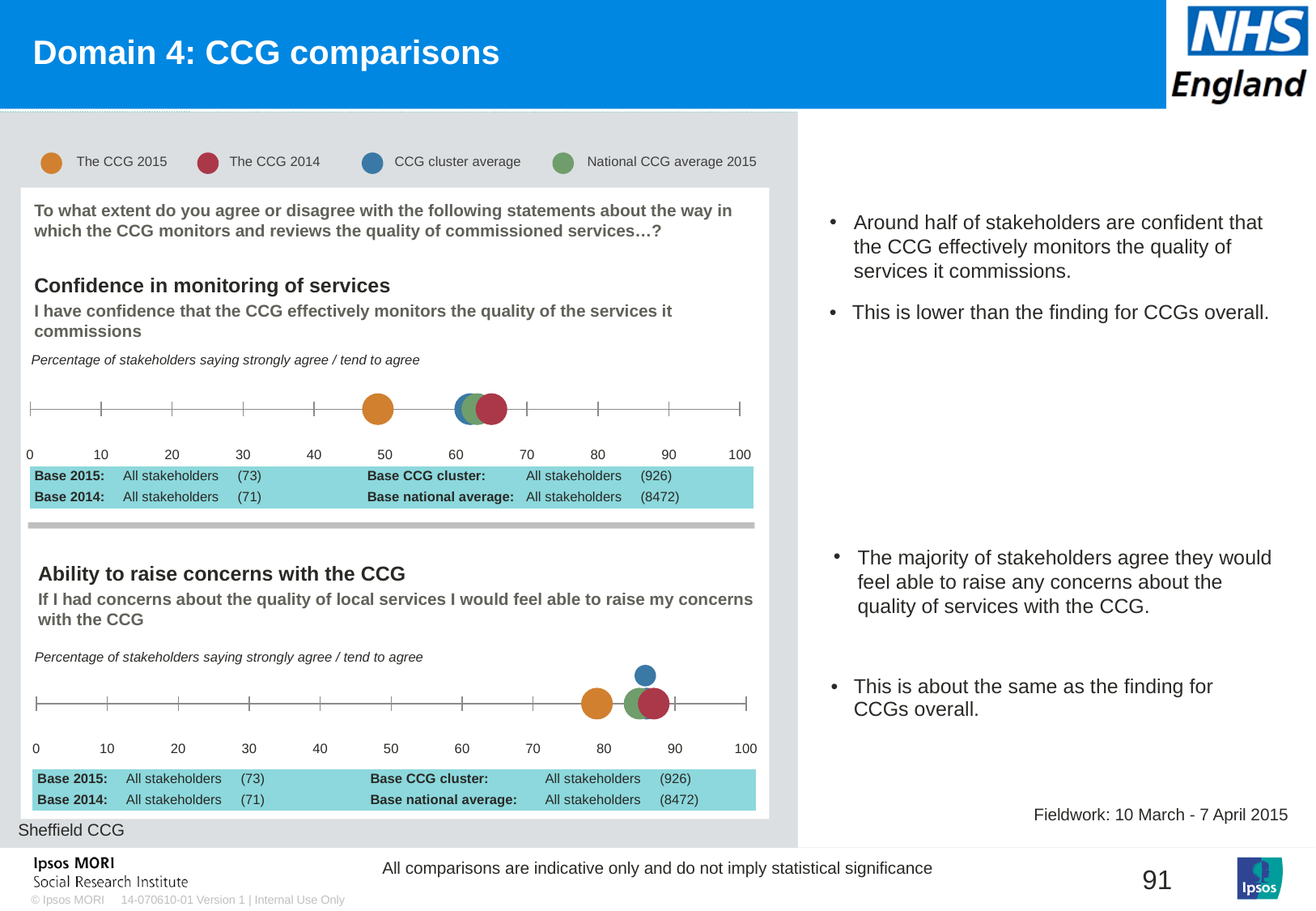
In the 'Ability to raise concerns with the CCG' chart, is the value for The CCG 2015 greater or less than 70? greater In the 'Ability to raise concerns with the CCG' chart, which series has the lowest value? The CCG 2015 In the 'Ability to raise concerns with the CCG' chart, which is larger, the value for The CCG 2015 or the National CCG average 2015? National CCG average 2015 In the 'Confidence in monitoring of services' chart, is the value for The CCG 2014 greater or less than 60? greater How many series does the legend at the top of the slide list? 4 In the 'Confidence in monitoring of services' chart, which is larger, the value for The CCG 2015 or The CCG 2014? The CCG 2014 In the 'Confidence in monitoring of services' chart, is the value for the CCG cluster average greater or less than 70? less What colour marker represents The CCG 2015 in the legend? Orange In the 'Confidence in monitoring of services' chart, which series has the lowest value? The CCG 2015